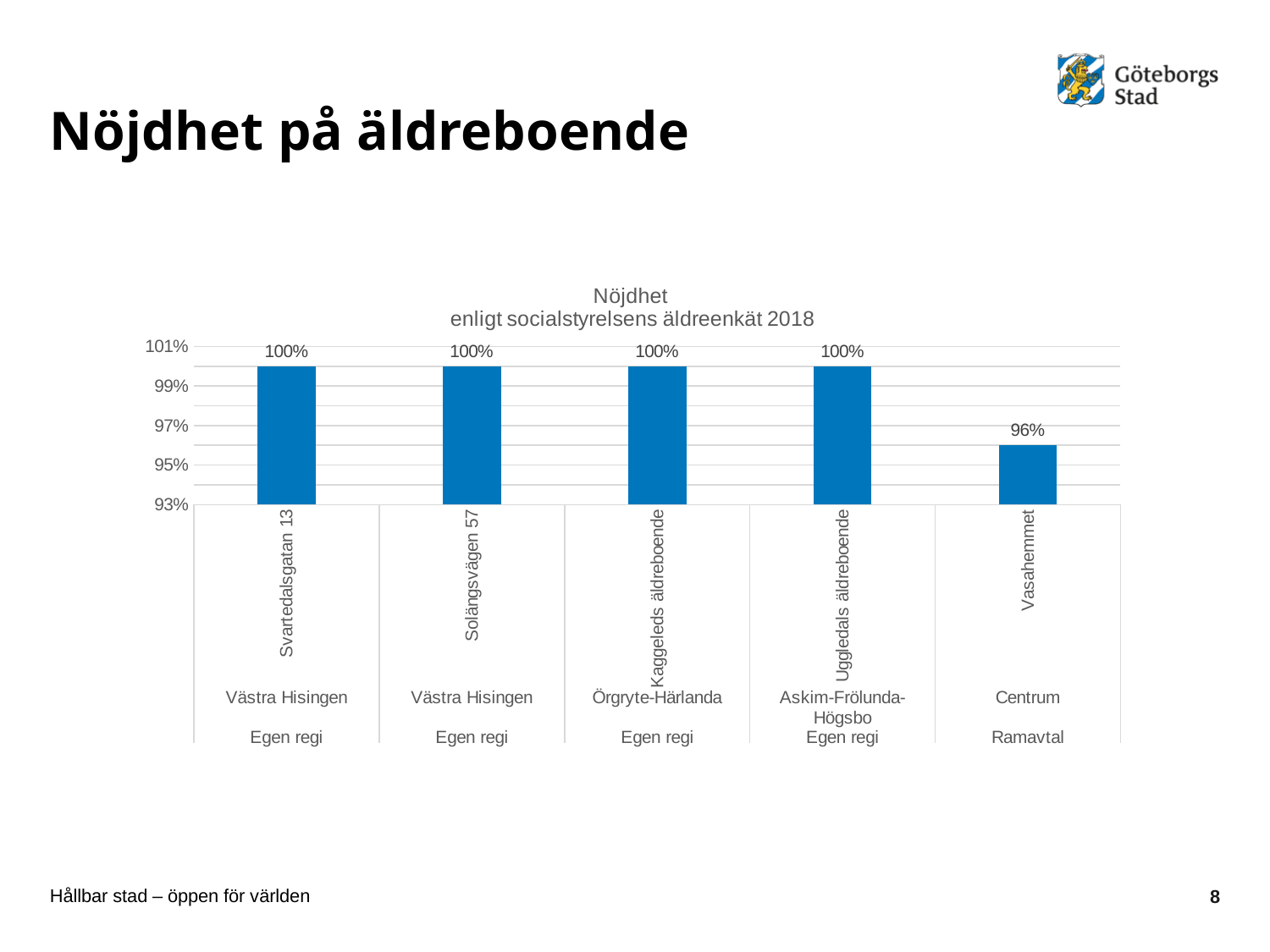
What is the value for Svartedalsgatan 13? 100% Which is larger, the value for Uggledals äldreboende or the value for Vasahemmet? Uggledals äldreboende What is the title of the chart? Nöjdhet enligt socialstyrelsens äldreenkät 2018 What is the value for Kaggeleds äldreboende? 100% What is the difference between the values for Solängsvägen 57 and Vasahemmet? 4% Which category is listed under Ramavtal rather than Egen regi? Vasahemmet How many categories have a value of 100%? 4 What is the value for Vasahemmet? 96% How many bars are shown in the chart? 5 What kind of chart is shown on the slide? bar chart Is the value for Vasahemmet greater or less than 97%? less Which category has the lowest value? Vasahemmet